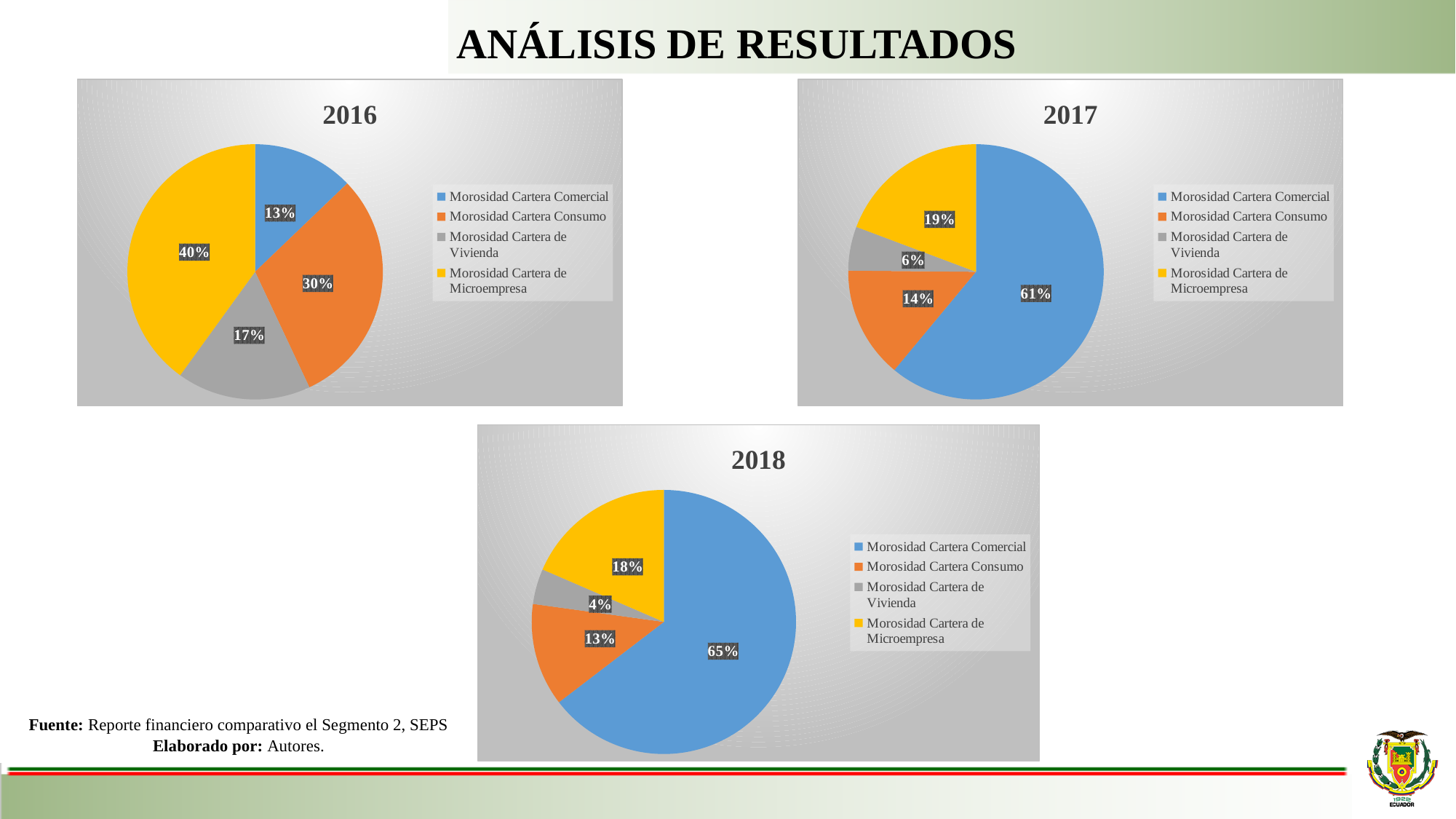
In the 2016 chart, which is larger: Morosidad Cartera Consumo or Morosidad Cartera de Vivienda? Morosidad Cartera Consumo In the 2017 chart, which category has the largest slice? Morosidad Cartera Comercial In the 2018 chart, what is the difference between Morosidad Cartera Comercial and Morosidad Cartera de Microempresa? 47% What type of chart is the 2018 chart? Pie chart How many categories does the 2017 chart show? 4 How many pie charts are shown on the slide? 3 In the 2018 chart, which category has the smallest slice? Morosidad Cartera de Vivienda In the 2018 chart, what is the value for Morosidad Cartera de Vivienda? 4% In the 2016 chart, what share does Morosidad Cartera de Microempresa have? 40% In the 2016 chart, which category has the smallest slice? Morosidad Cartera Comercial In the 2017 chart, what is the value for Morosidad Cartera Comercial? 61% In the 2017 chart, what is the difference between Morosidad Cartera de Microempresa and Morosidad Cartera Consumo? 5%